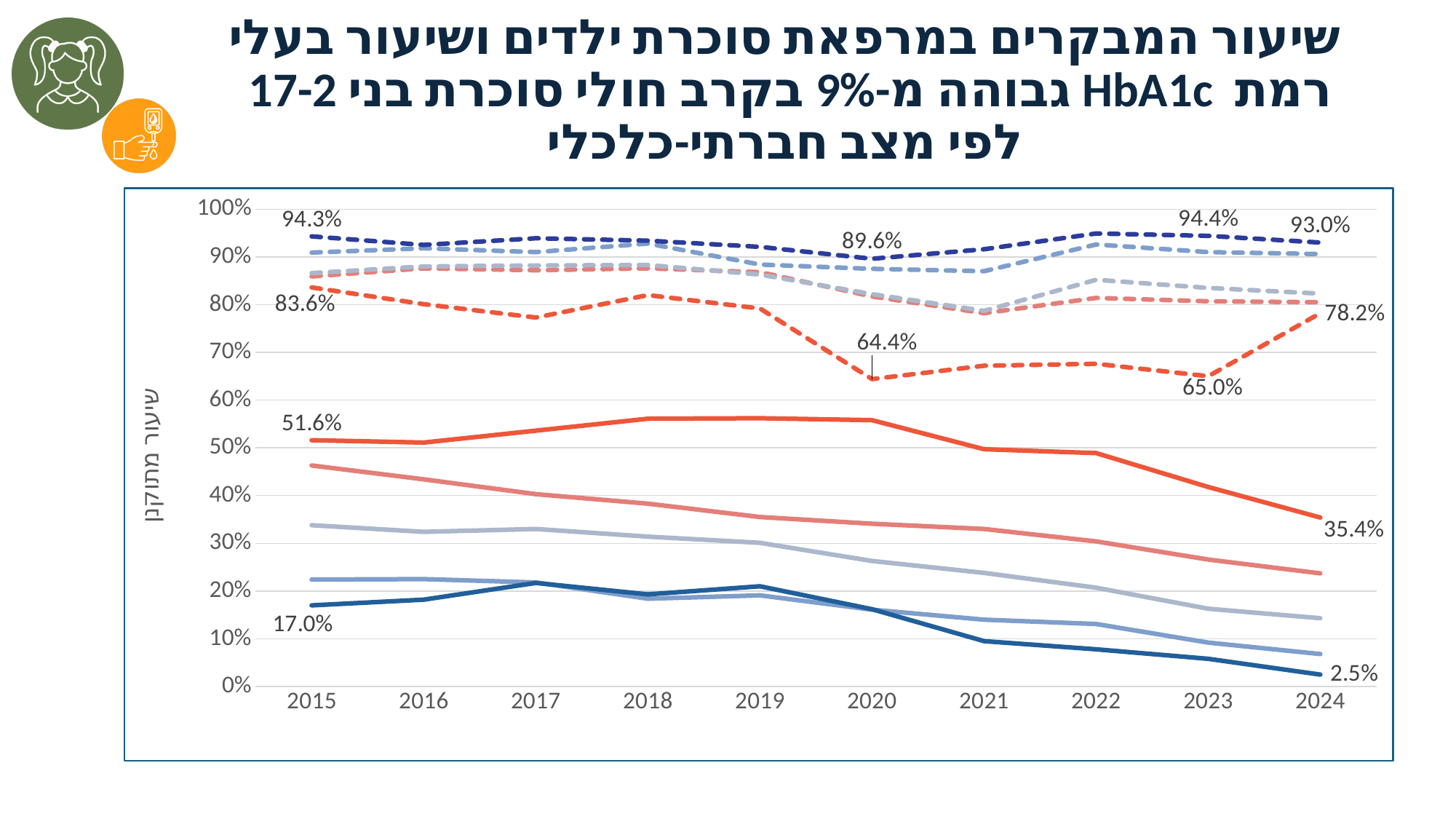
What is the labelled value of the solid dark blue line in 2015? 17.0% What is the labelled value of the dark blue dashed line in 2024? 93.0% Which of the labelled values on the dark blue dashed line is the lowest? 89.6% (2020) By how many percentage points did the solid orange line fall from its 2015 label (51.6%) to its 2024 label (35.4%)? 16.2 Does the solid orange line rise or fall between 2020 and 2024? fall What kind of chart is shown on the slide? line chart What is the labelled value of the solid orange line in 2024? 35.4% By how many percentage points did the solid dark blue line fall from 2015 (17.0%) to 2024 (2.5%)? 14.5 How many years are shown along the x axis? 10 Is the value of the solid orange line in 2018 greater or less than 50%? greater What is the labelled value of the dark blue dashed line in 2015? 94.3% What is the labelled value of the orange dashed line in 2020? 64.4%